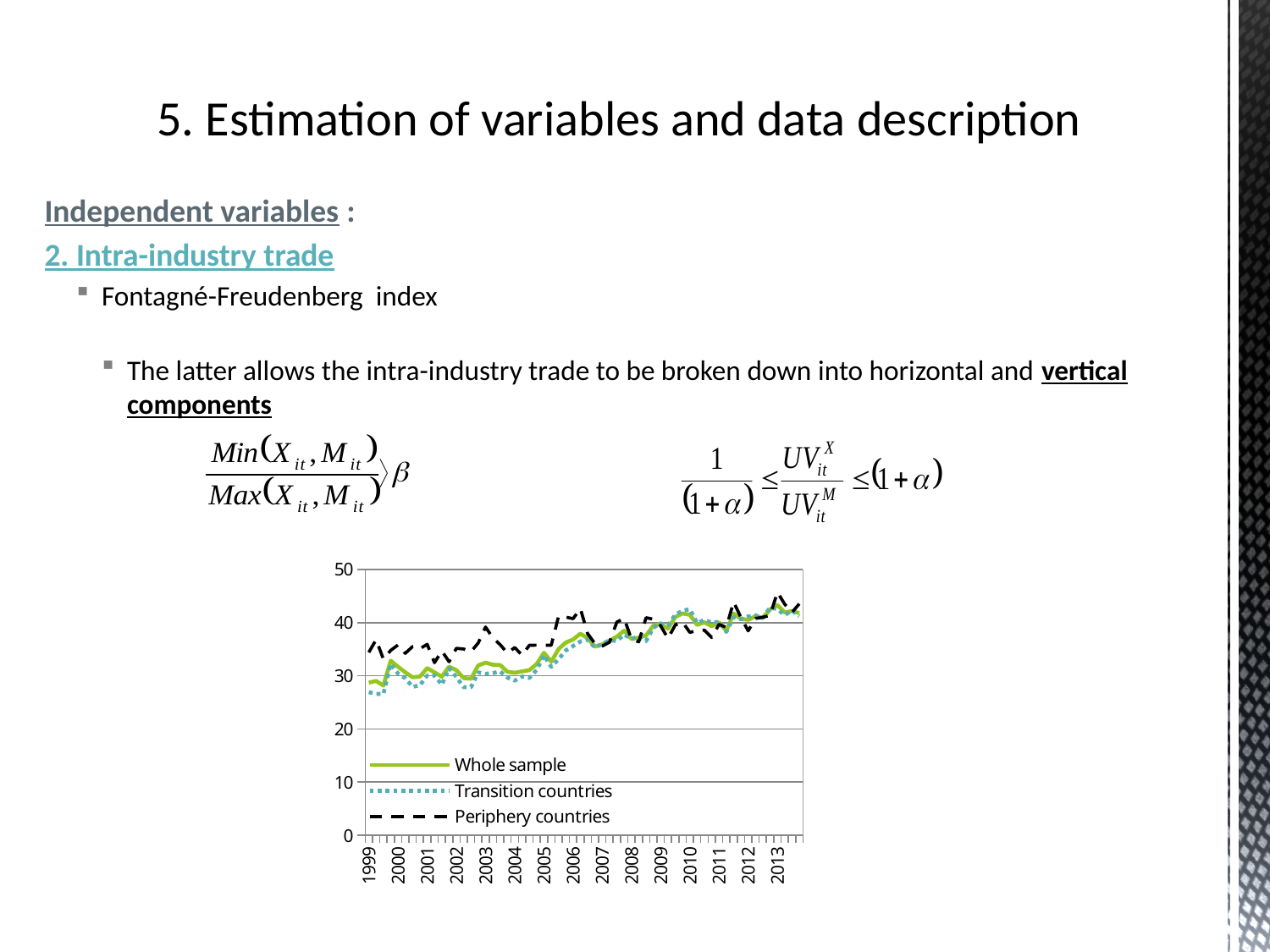
Is the value for the Whole sample at the end of 2013 greater or less than 40? greater How many year labels are shown on the chart's x axis? 15 What kind of chart is shown on the slide? line chart Is the value for Transition countries in 2003 greater or less than 40? less Which series in the chart is drawn with a black dashed line? Periphery countries Do the values for the Whole sample series generally rise or fall from 1999 to 2013? rise Is the value for Transition countries at the start of 1999 greater or less than 30? less In 2003, which is larger: the value for Periphery countries or the value for the Whole sample? Periphery countries How many series does the chart's legend list? 3 At the start of 1999, which is larger: the value for Periphery countries or the value for Transition countries? Periphery countries Which series are listed in the chart's legend? Whole sample, Transition countries, Periphery countries